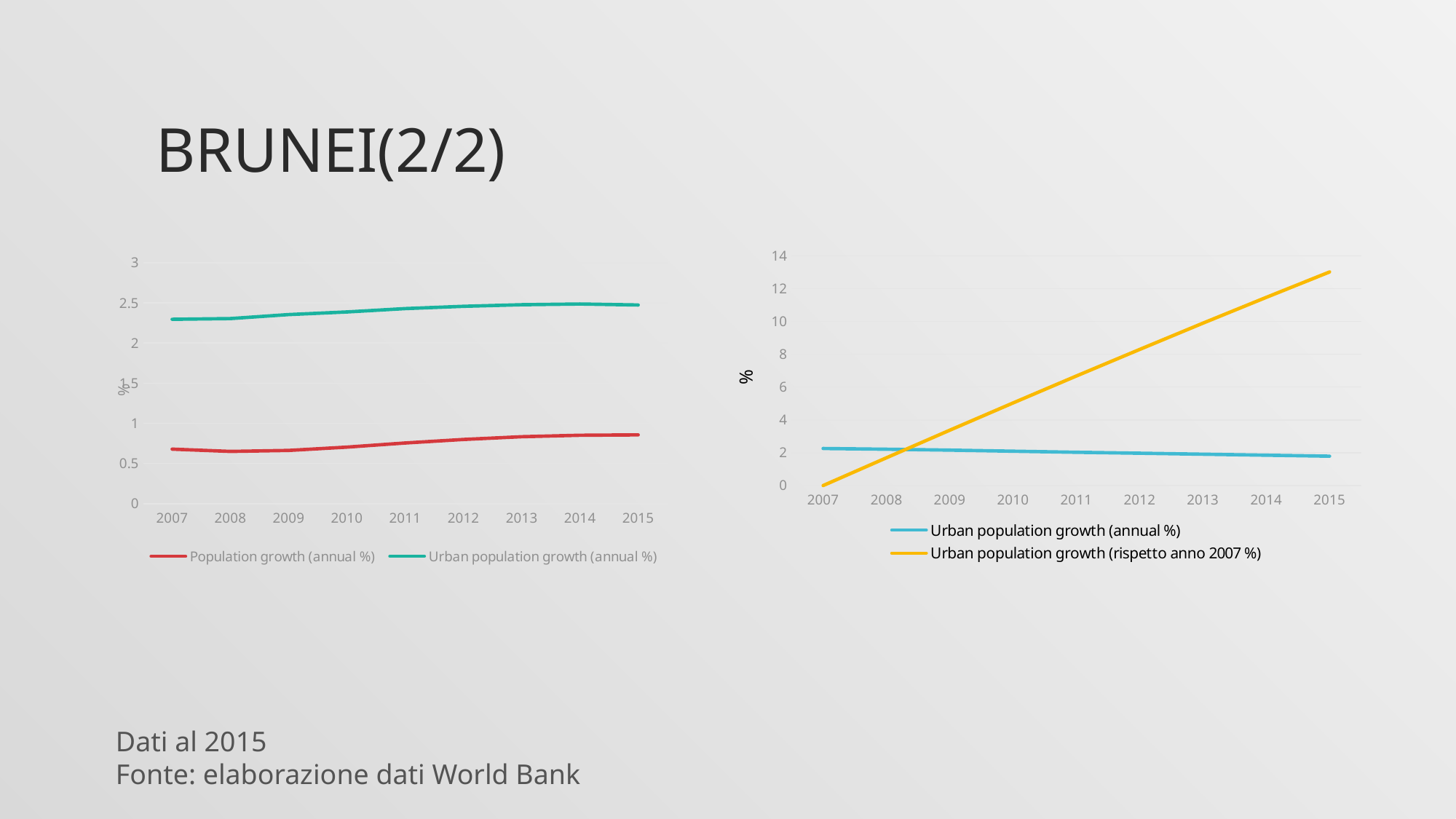
In the right chart, what is the value for Urban population growth (rispetto anno 2007 %) in 2007? 0 How many series does the legend of the right chart list? 2 In the right chart, which year has the highest value for Urban population growth (rispetto anno 2007 %)? 2015 In the right chart, is the value for Urban population growth (rispetto anno 2007 %) in 2015 greater or less than 12? greater What kind of chart is the left chart on the slide? line chart In the right chart, is the value for Urban population growth (annual %) in 2015 greater or less than 4? less In the left chart, what colour is the line for Population growth (annual %)? red In the left chart, which series has the higher value in 2015, Population growth (annual %) or Urban population growth (annual %)? Urban population growth (annual %) In the right chart, does the Urban population growth (rispetto anno 2007 %) line rise or fall from 2007 to 2015? rise In the left chart, is the value for Population growth (annual %) in 2007 greater or less than 1? less How many years are shown on the x axis of the left chart? 9